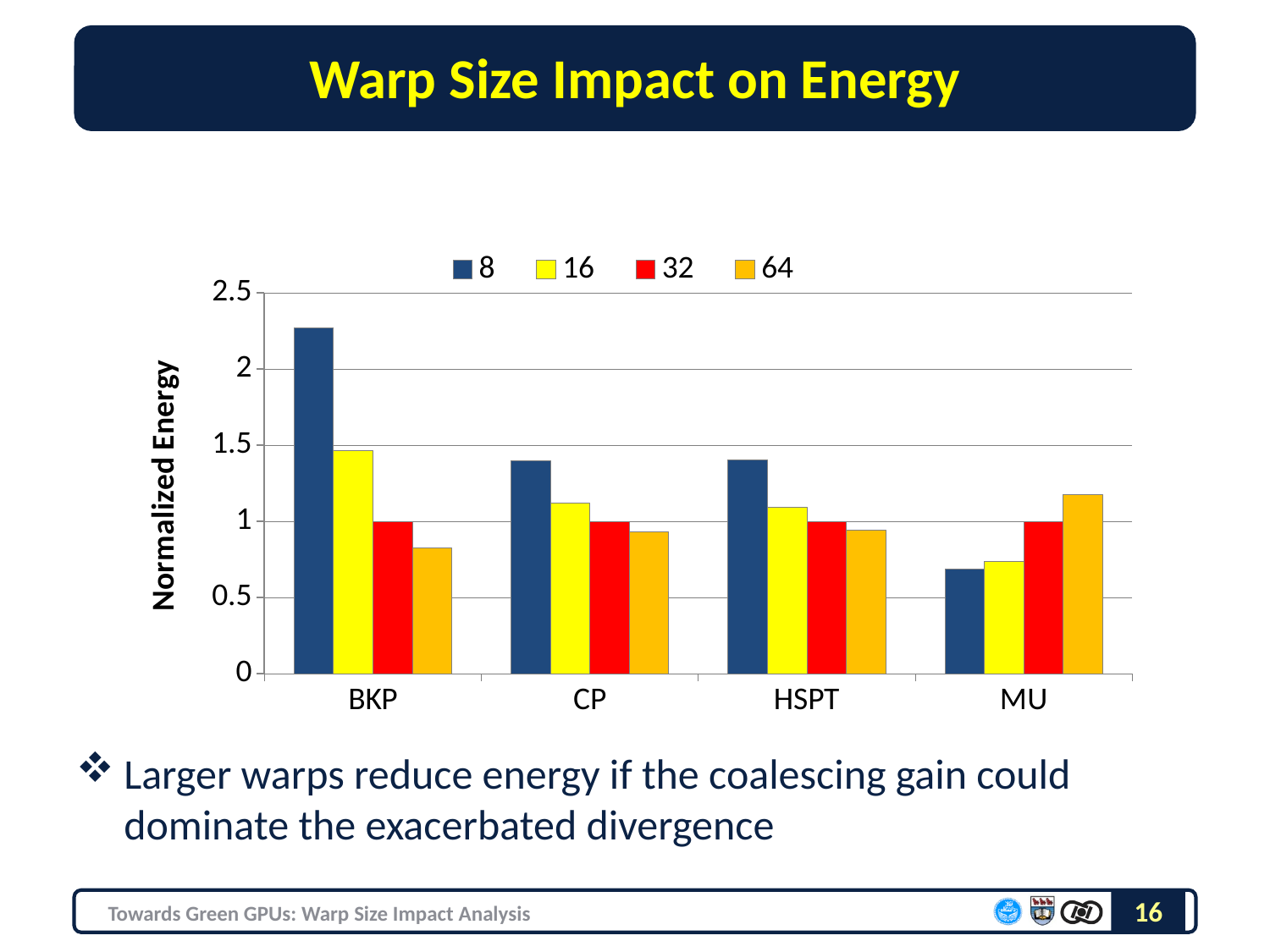
For BKP, which series has the larger value, 16 or 64? 16 Which category has the lowest bar for the 8 series? MU Which category has the highest bar for the 8 series? BKP Within the BKP category, do the bars rise or fall as warp size increases from 8 to 64? fall What is the label on the y axis? Normalized Energy How many benchmark categories are shown on the x axis? 4 Is the value for BKP in the 64 series greater or less than 1? less What kind of chart is shown on the slide? bar chart Is the value for BKP in the 8 series greater or less than 2? greater Is the value for MU in the 8 series greater or less than 1? less How many series does the legend list? 4 For MU, which series has the larger value, 8 or 64? 64